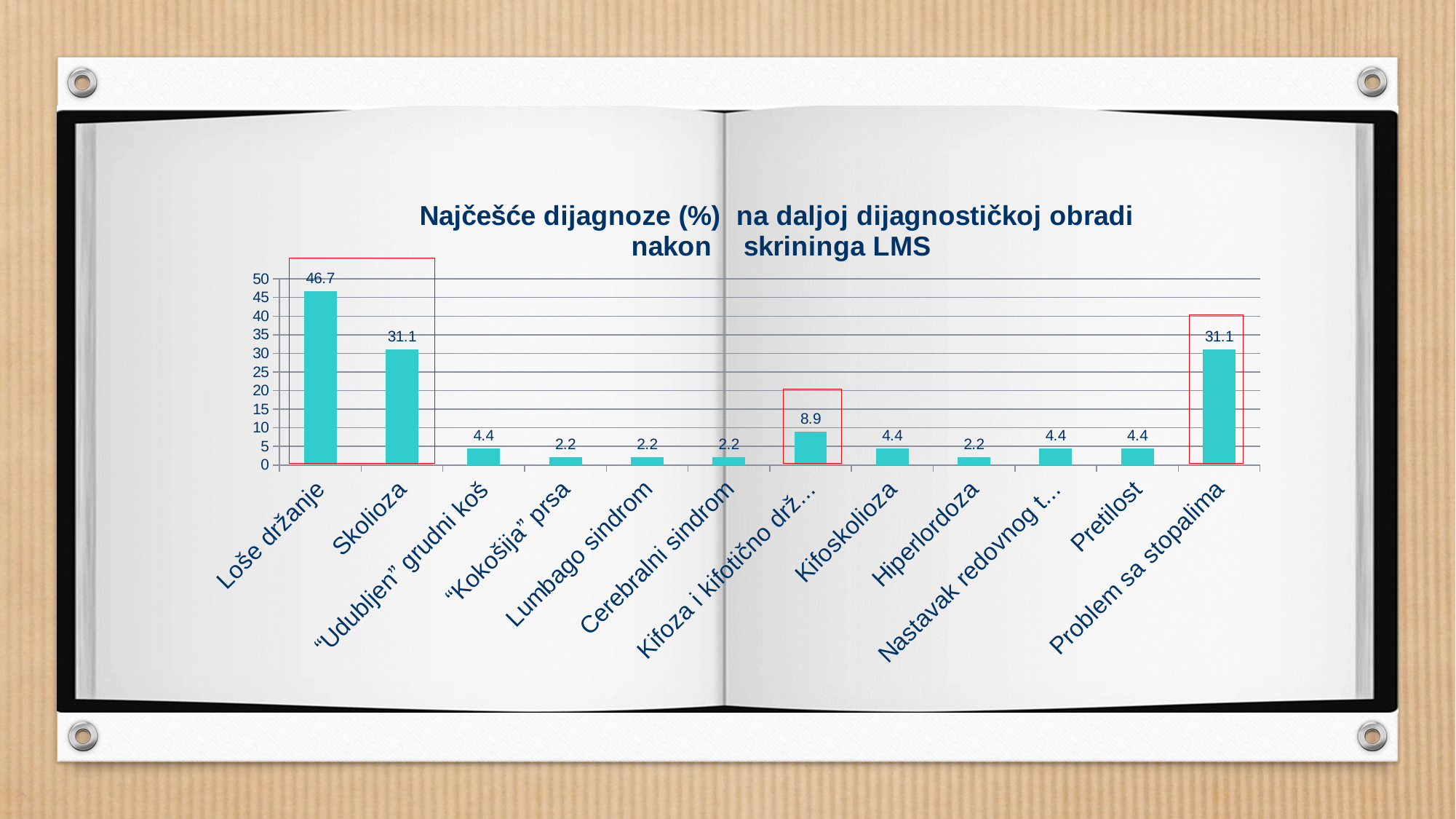
What is the value for Skolioza? 31.1 What is the value for Problem sa stopalima? 31.1 What is the value for Hiperlordoza? 2.2 What kind of chart is shown on the slide? Bar chart Which is larger, the value for Skolioza or the value for Kifoskolioza? Skolioza How many categories are shown on the x axis? 12 What is the title of the chart? Najčešće dijagnoze (%) na daljoj dijagnostičkoj obradi nakon skrininga LMS Which category has the highest value? Loše držanje What is the value for Kifoskolioza? 4.4 What is the difference between the values for Pretilost and Lumbago sindrom? 2.2 What is the difference between the values for Loše držanje and Skolioza? 15.6 What is the value for Loše držanje? 46.7